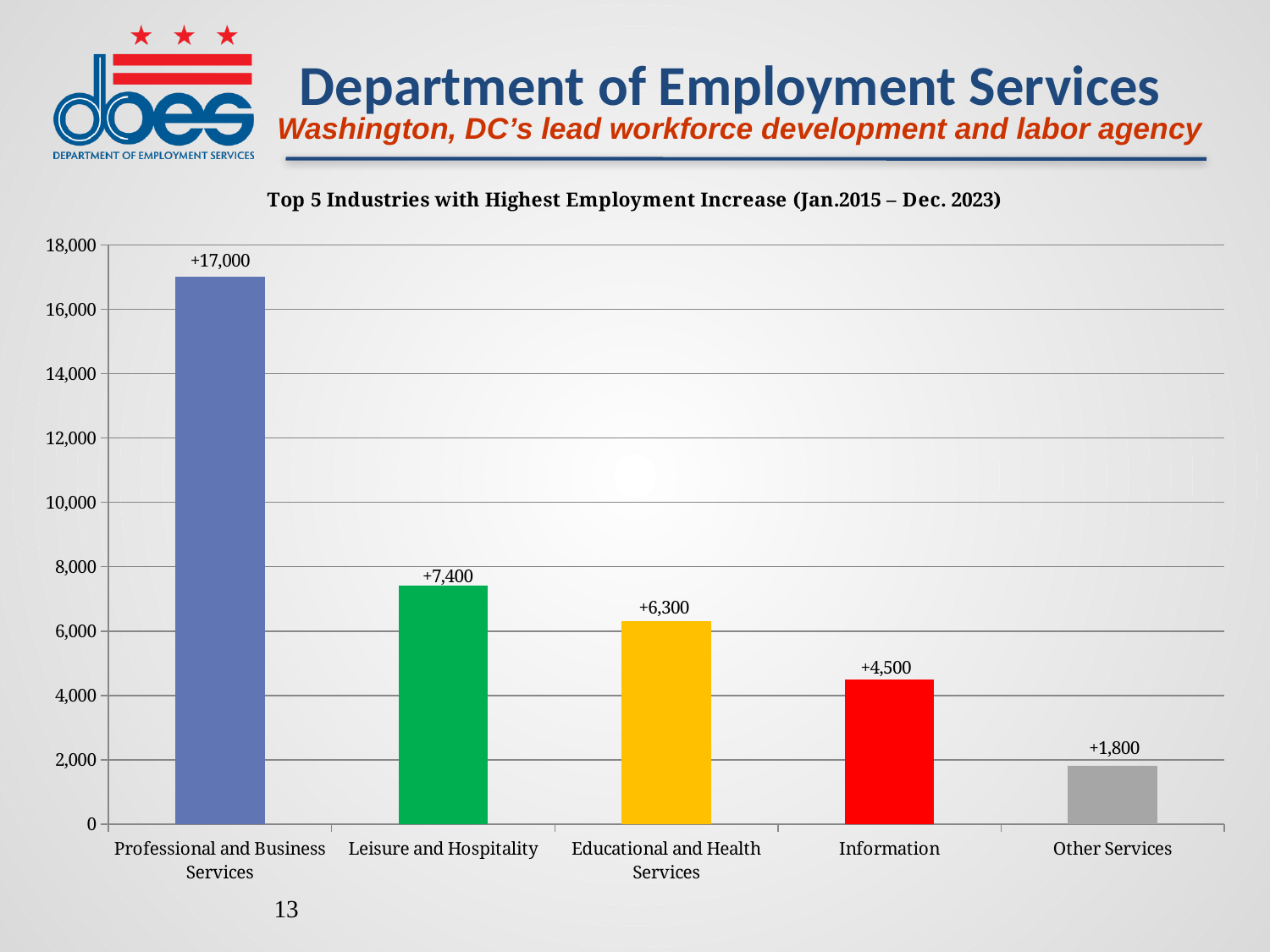
What is the title of the chart? Top 5 Industries with Highest Employment Increase (Jan.2015 – Dec. 2023) Which industry has the highest employment increase? Professional and Business Services What is the employment increase shown for Educational and Health Services? +6,300 What is the employment increase shown for Information? +4,500 What is the difference between the employment increase for Professional and Business Services and for Leisure and Hospitality? 9,600 How many industries are shown in the chart? 5 What is the employment increase shown for Professional and Business Services? +17,000 What is the employment increase shown for Other Services? +1,800 Which has a larger employment increase, Educational and Health Services or Information? Educational and Health Services Which industry has the lowest employment increase? Other Services What kind of chart is shown on the slide? Bar chart What is the employment increase shown for Leisure and Hospitality? +7,400